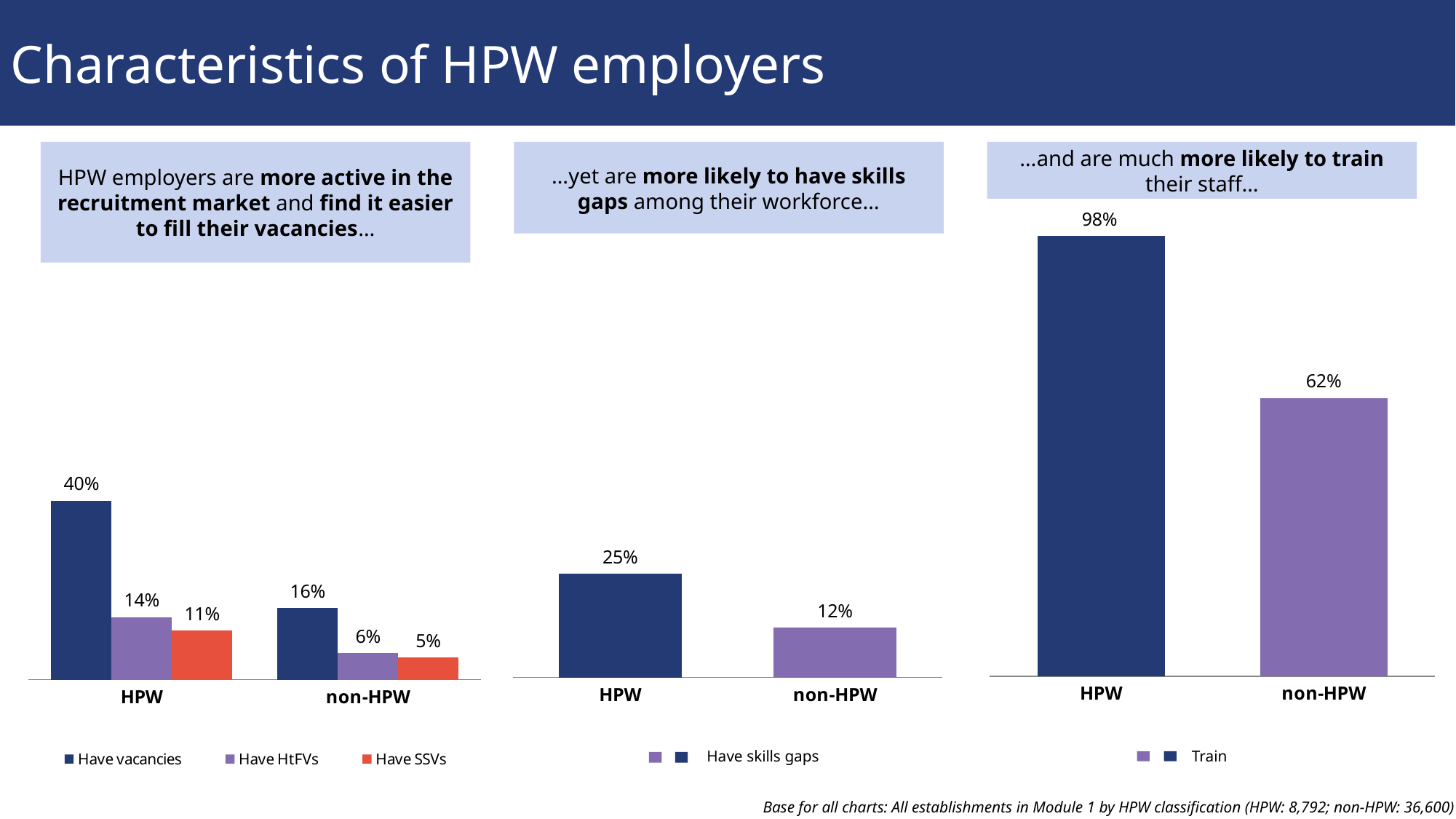
What type of chart is the right chart on training? Bar chart In the left chart on recruitment, which bar is the lowest? non-HPW, Have SSVs (5%) In the left chart on recruitment, what percentage of HPW employers have vacancies? 40% In the left chart on recruitment, what percentage of non-HPW employers have HtFVs? 6% In the left chart on recruitment, how many series does the legend list? 3 In the left chart on recruitment, what percentage of HPW employers have SSVs? 11% In the left chart on recruitment, what is the difference between the share of HPW and non-HPW employers that have vacancies? 24 percentage points In the middle chart on skills gaps, what percentage of non-HPW employers have skills gaps? 12% In the right chart on training, what percentage of HPW employers train their staff? 98% In the middle chart on skills gaps, what percentage of HPW employers have skills gaps? 25% In the right chart on training, what is the difference between the share of HPW and non-HPW employers that train? 36 percentage points In the middle chart on skills gaps, which group has the higher share with skills gaps, HPW or non-HPW? HPW